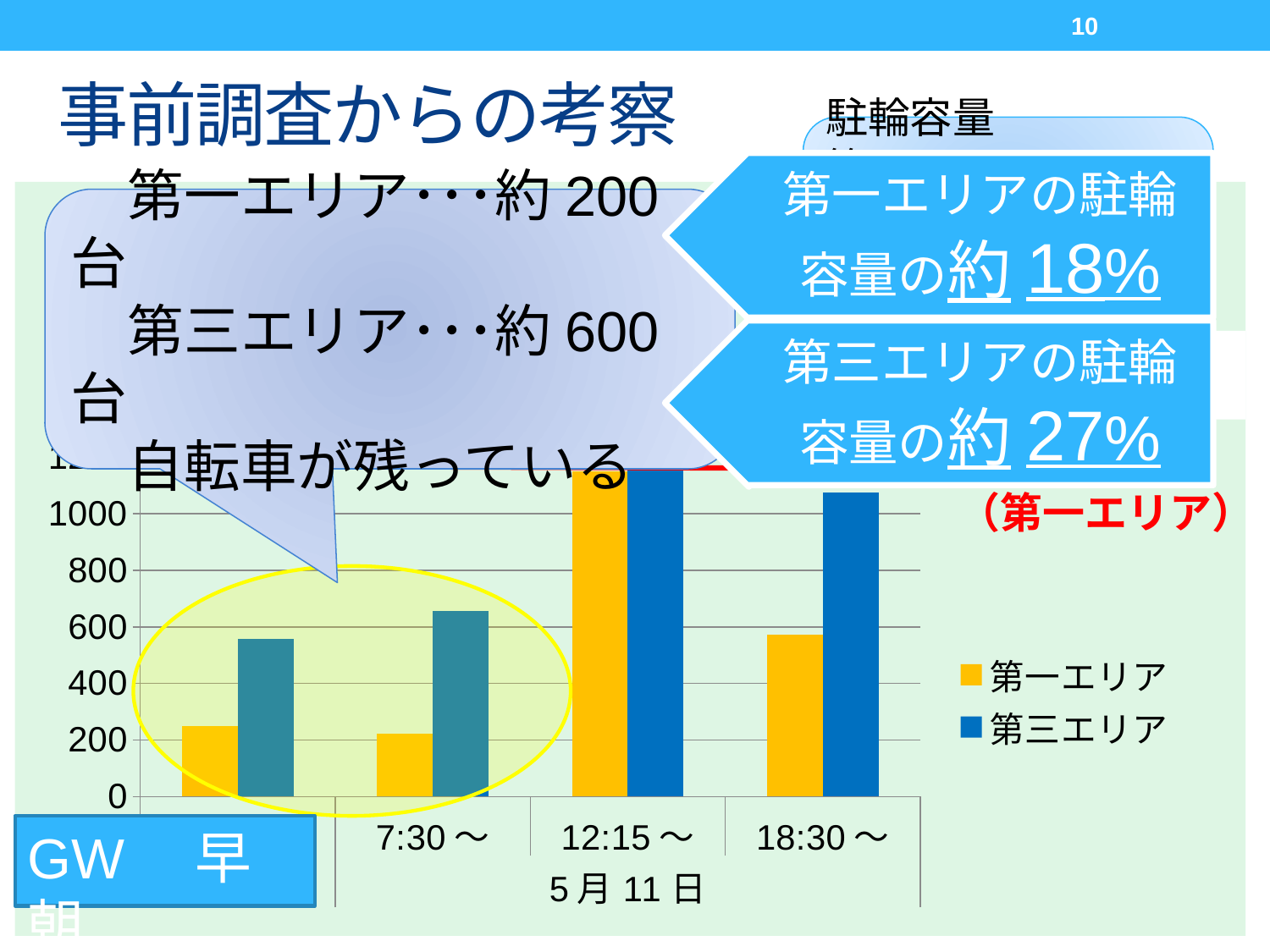
Which series has the higher value at 18:30～? 第三エリア Does the value for 第一エリア rise or fall from 12:15～ to 18:30～? fall Is the value for 第三エリア at 7:30～ greater or less than 600? greater Is the value for 第一エリア at 18:30～ greater or less than 400? greater At which time category is the value for 第三エリア lowest? GW 早朝 At which time category is the value for 第一エリア highest? 12:15～ Which series has the higher value at 7:30～? 第三エリア How many series does the chart legend list? 2 At which time category is the value for 第三エリア highest? 12:15～ What kind of chart is shown on the slide? bar chart Is the value for 第一エリア at 7:30～ greater or less than 400? less How many time categories are shown on the x axis of the chart? 4